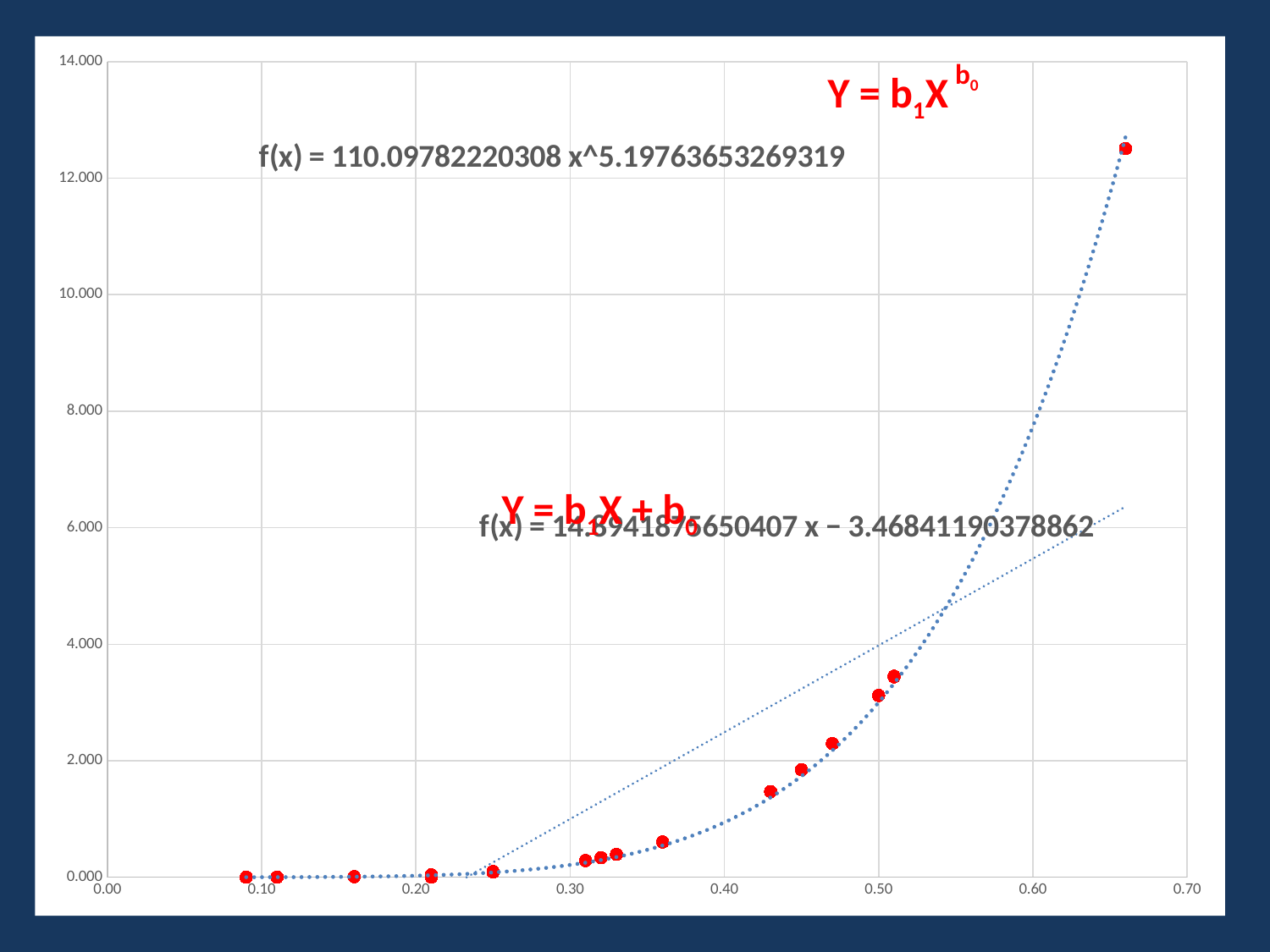
What kind of chart is shown on the slide? scatter chart Is the y value of the rightmost data point greater or less than 12.000? greater What is the highest value shown on the x axis? 0.70 What is the power trendline equation printed on the chart? f(x) = 110.09782220308 x^5.19763653269319 Is the y value of the data point near x = 0.43 greater or less than 2.000? less What colour are the data points on the chart? red Do the plotted values generally rise or fall as x increases along the x axis? rise What is the intercept in the linear trendline equation printed on the chart? − 3.46841190378862 Which data point has the highest y value: the one near x = 0.66 or the one near x = 0.51? the one near x = 0.66 How many trendlines are drawn on the chart? 2 What is the highest value shown on the y axis? 14.000 Is the y value of the data point near x = 0.50 greater or less than 4.000? less